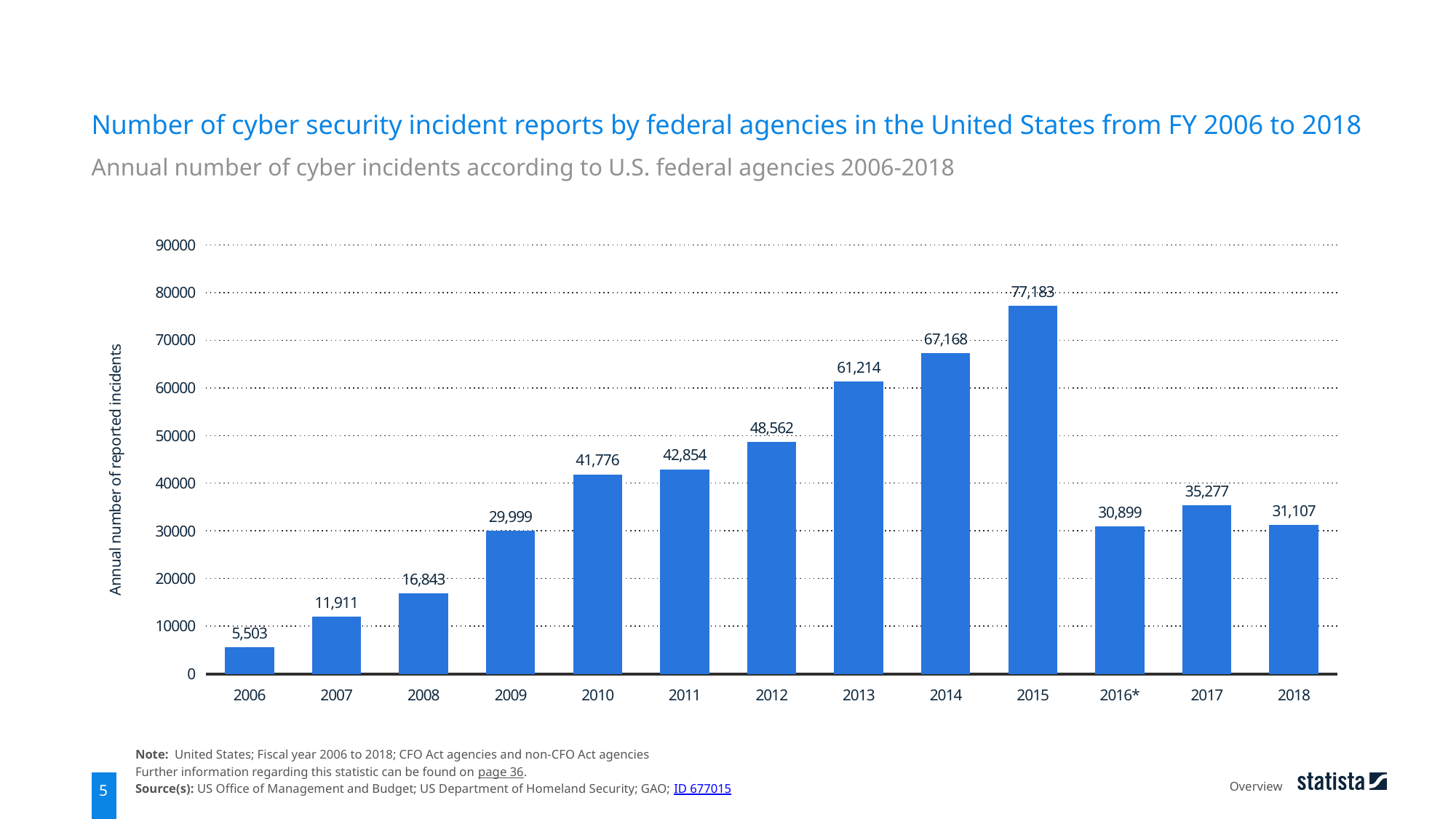
What is the number of reported incidents for 2016*? 30,899 Do the values rise or fall from 2006 to 2015? rise What is the number of reported incidents for 2006? 5,503 What is the difference between the number of reported incidents in 2015 and 2014? 10,015 Which year has the highest number of reported incidents? 2015 Which year has the lowest number of reported incidents? 2006 What kind of chart is shown on the slide? bar chart What is the number of reported incidents for 2015? 77,183 What is the label of the y axis? Annual number of reported incidents How many years are shown on the x axis? 13 Which year has more reported incidents, 2017 or 2018? 2017 Is the value for 2012 greater or less than 50000? less